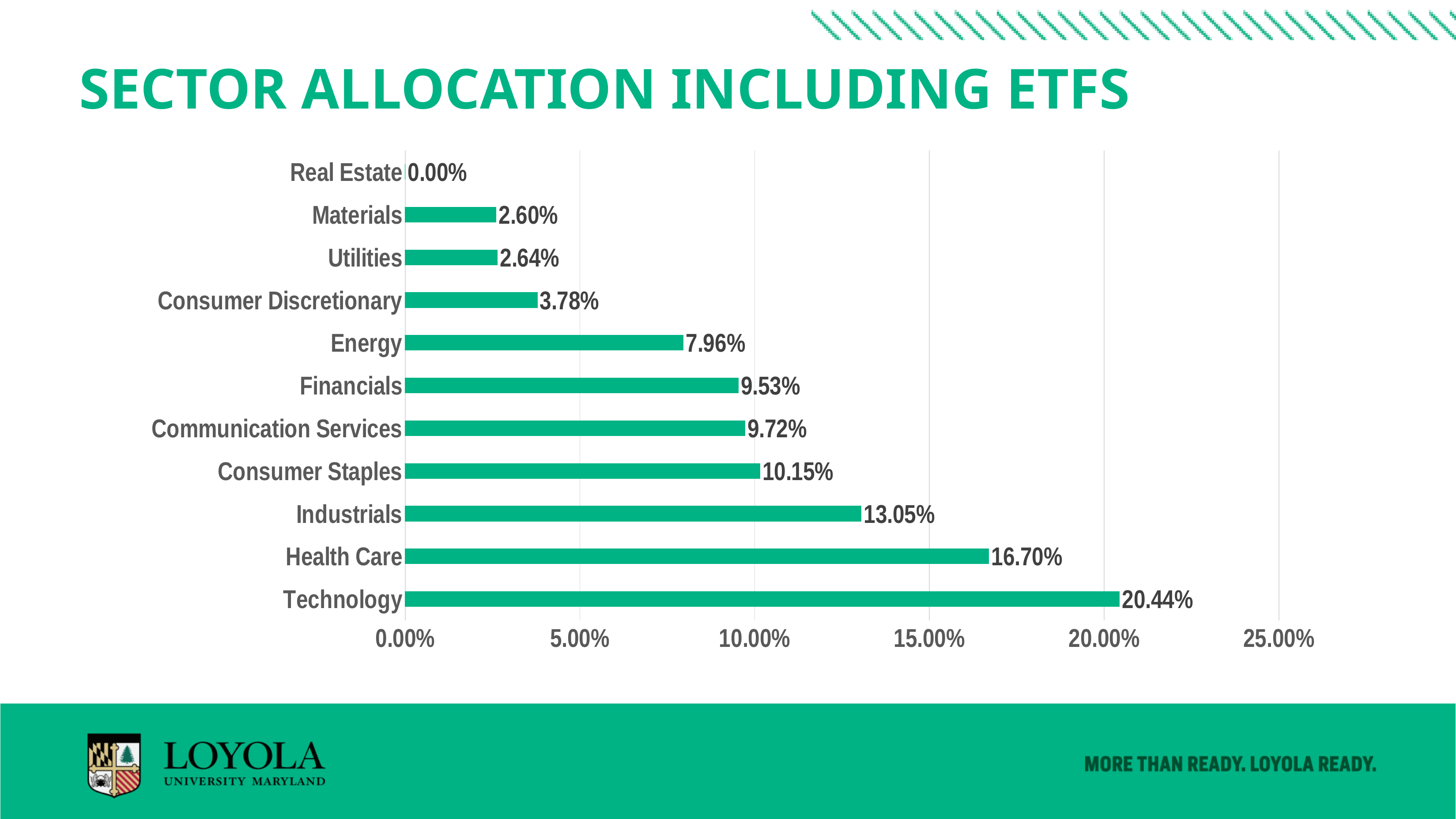
How many sectors are shown in the chart? 11 What is the allocation for Technology? 20.44% What is the allocation for Energy? 7.96% Which sector has the lowest allocation? Real Estate Which has a larger allocation, Industrials or Consumer Staples? Industrials What is the difference between the Health Care and Industrials allocations? 3.65% Which sector has the highest allocation? Technology What is the difference between the Technology and Health Care allocations? 3.74% What kind of chart is shown on the slide? Bar chart Which has a larger allocation, Financials or Energy? Financials What is the allocation for Consumer Staples? 10.15% What is the title of the slide? SECTOR ALLOCATION INCLUDING ETFS